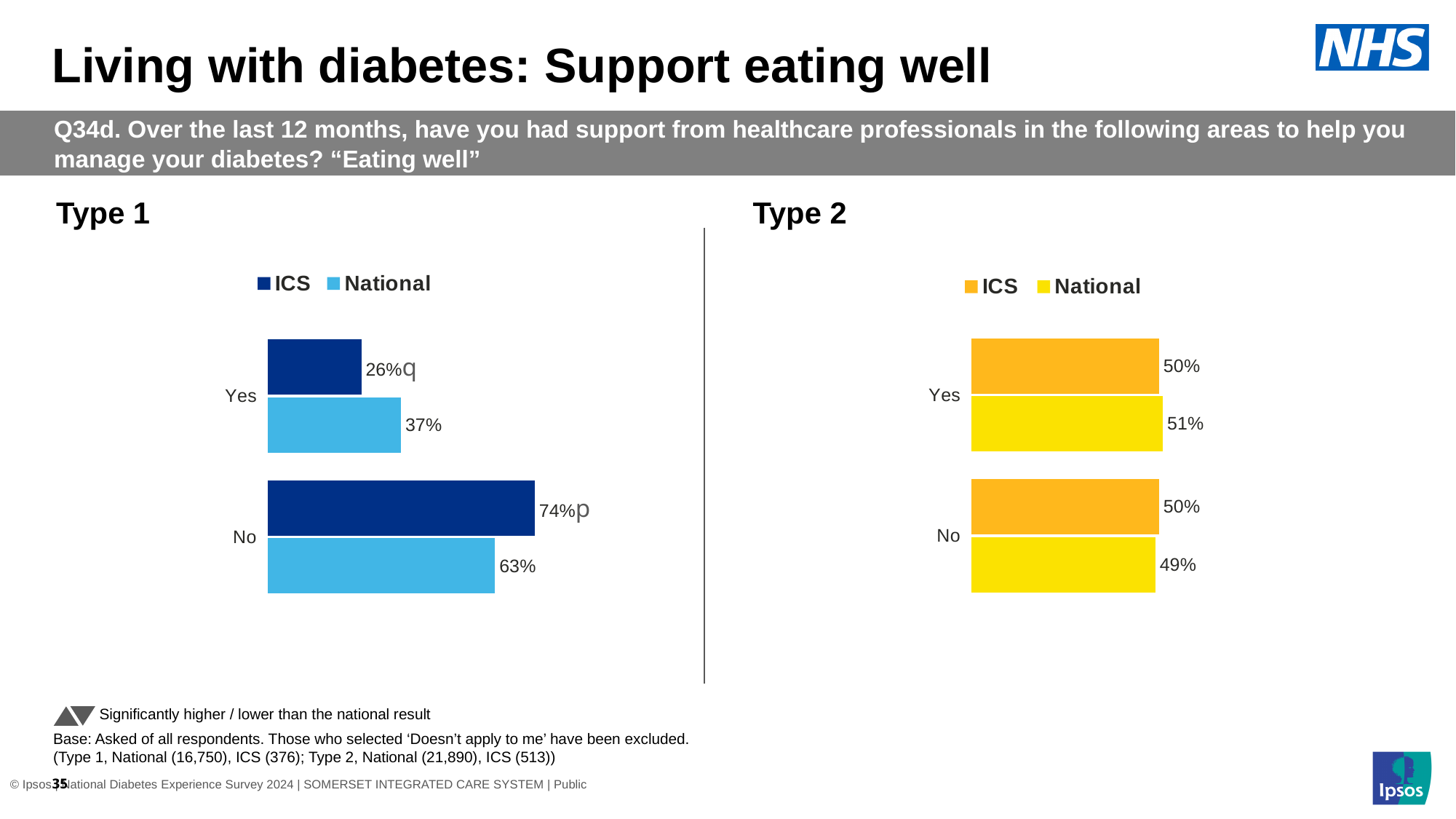
In the Type 2 chart, what is the ICS value for No? 50% In the Type 1 chart, what is the difference between the ICS and National values for No? 11 percentage points In the Type 1 chart, which bar has the lowest value? ICS, Yes (26%) How many series does the legend of the Type 2 chart list? 2 In the Type 1 chart, what is the ICS value for Yes? 26% In the Type 1 chart, which is larger for Yes: the ICS value or the National value? National In the Type 1 chart, what is the National value for No? 63% In the Type 1 chart, what is the difference between the National and ICS values for Yes? 11 percentage points In the Type 2 chart, which is larger for No: the ICS value or the National value? ICS In the Type 2 chart, what is the National value for Yes? 51% In the Type 1 chart, which bar has the highest value? ICS, No (74%) What type of chart is used for Type 1? Bar chart